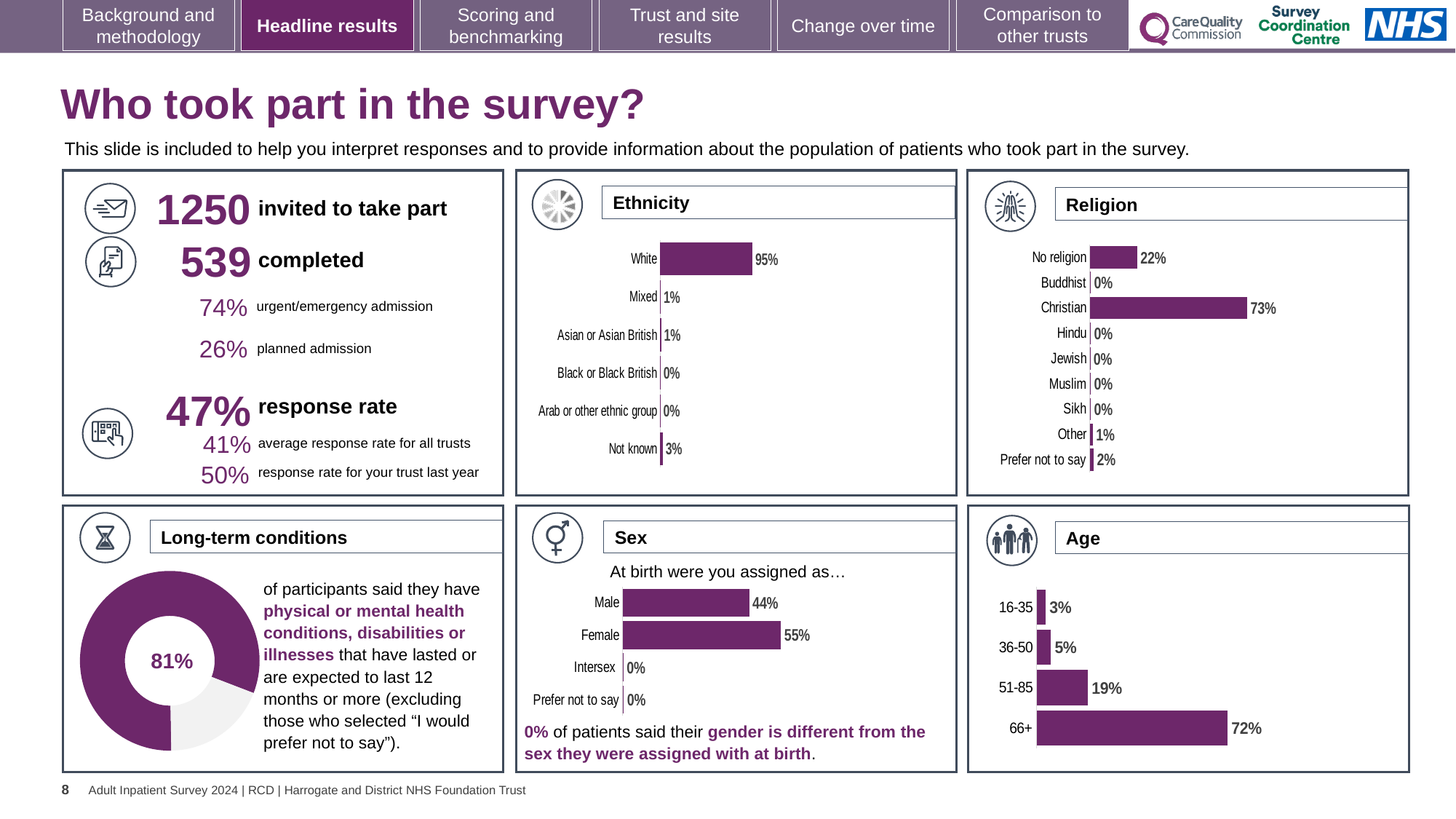
In the Sex chart, what is the difference between the Female and Male values? 11% In the Religion chart, what is the difference between the Christian and No religion values? 51% In the Age chart, do the values rise or fall as the age groups increase from 16-35 to 66+? rise In the Ethnicity chart, what percentage of respondents were White? 95% In the Age chart, what percentage of respondents were aged 66+? 72% What kind of chart is used in the Long-term conditions panel? doughnut chart In the Ethnicity chart, what percentage of respondents were Not known? 3% In the Religion chart, what percentage of respondents had No religion? 22% In the Sex chart, which is larger, Male or Female? Female In the Age chart, which age group has the lowest value? 16-35 How many categories are shown in the Religion chart? 9 In the Religion chart, which category has the highest value? Christian